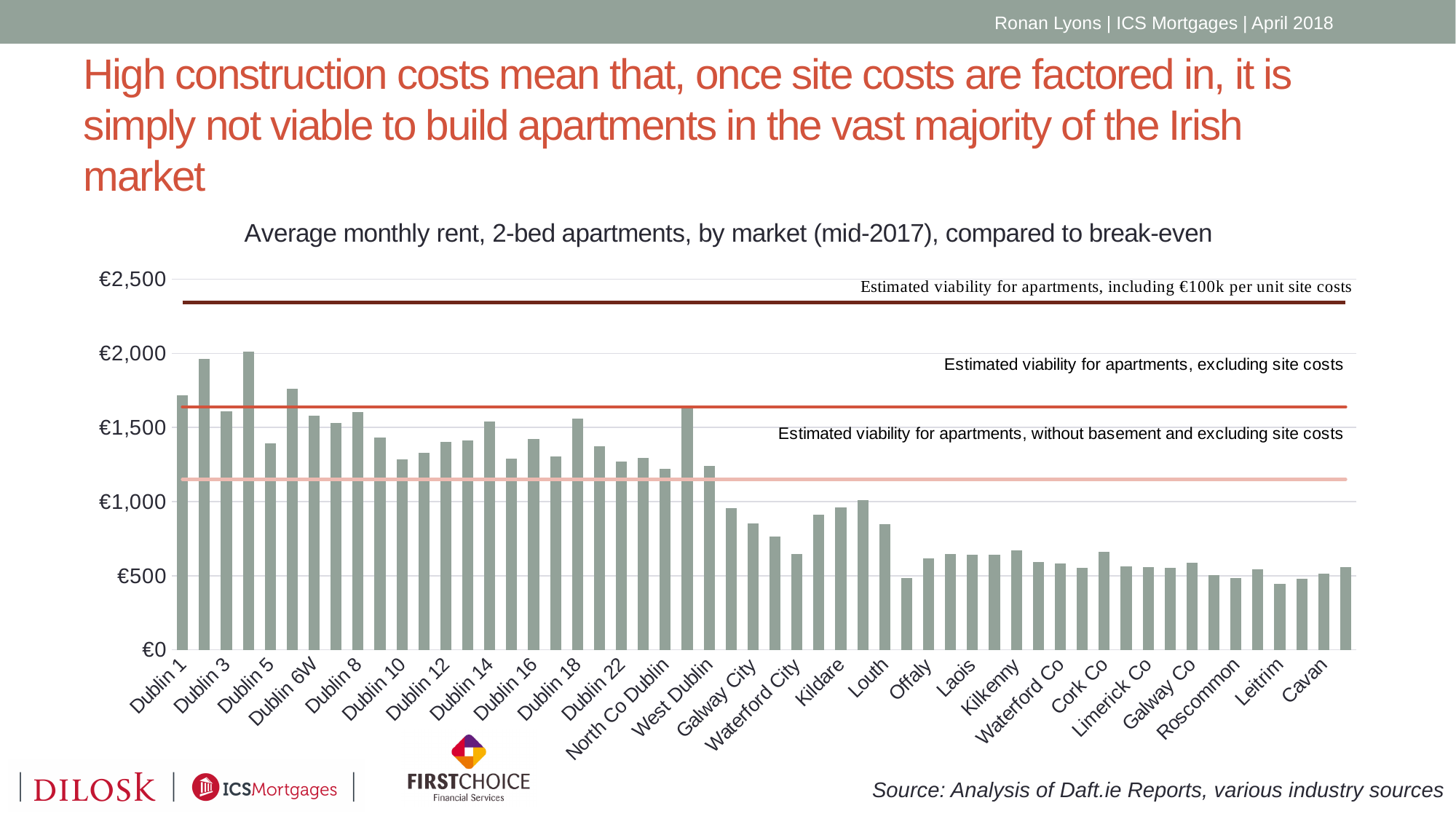
Which is larger, the value for Dublin 1 or the value for Dublin 5? Dublin 1 Is the value for Dublin 5 greater or less than €1,500? less Do the values generally rise or fall moving from left to right along the x axis? fall Is the value for Laois greater or less than €500? greater Is the value for West Dublin greater or less than €1,000? greater How many horizontal viability reference lines are drawn across the chart? 3 What is the title of the chart? Average monthly rent, 2-bed apartments, by market (mid-2017), compared to break-even What kind of chart is shown on the slide? bar chart